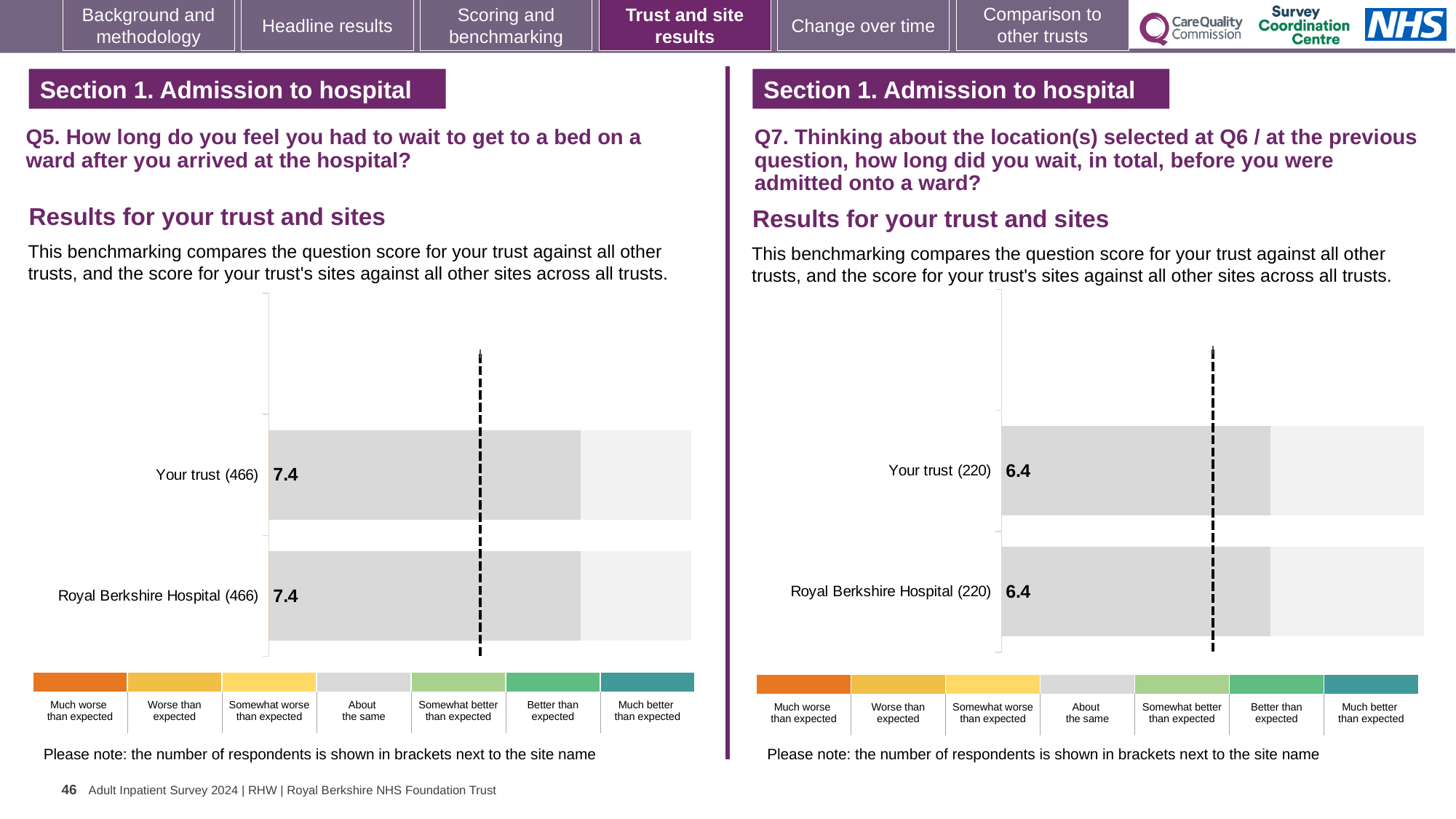
In the Q5 chart on the left, what is the score for Your trust? 7.4 In the Q5 chart on the left, what is the difference between the score for Your trust and the score for Royal Berkshire Hospital? 0.0 What kind of chart is the Q5 chart on the left? Bar chart In the Q5 chart on the left, how many respondents are shown in brackets next to Your trust? 466 In the Q7 chart on the right, what is the difference between the score for Your trust and the score for Royal Berkshire Hospital? 0.0 In the Q5 chart on the left, what is the score for Royal Berkshire Hospital? 7.4 In the Q7 chart on the right, what is the score for Royal Berkshire Hospital? 6.4 How many bars are plotted in the Q5 chart on the left? 2 In the Q7 chart on the right, how many respondents are shown in brackets next to Royal Berkshire Hospital? 220 Is the score for Your trust in the Q5 chart on the left larger or smaller than the score for Your trust in the Q7 chart on the right? Larger How many bars are plotted in the Q7 chart on the right? 2 In the Q7 chart on the right, what is the score for Your trust? 6.4